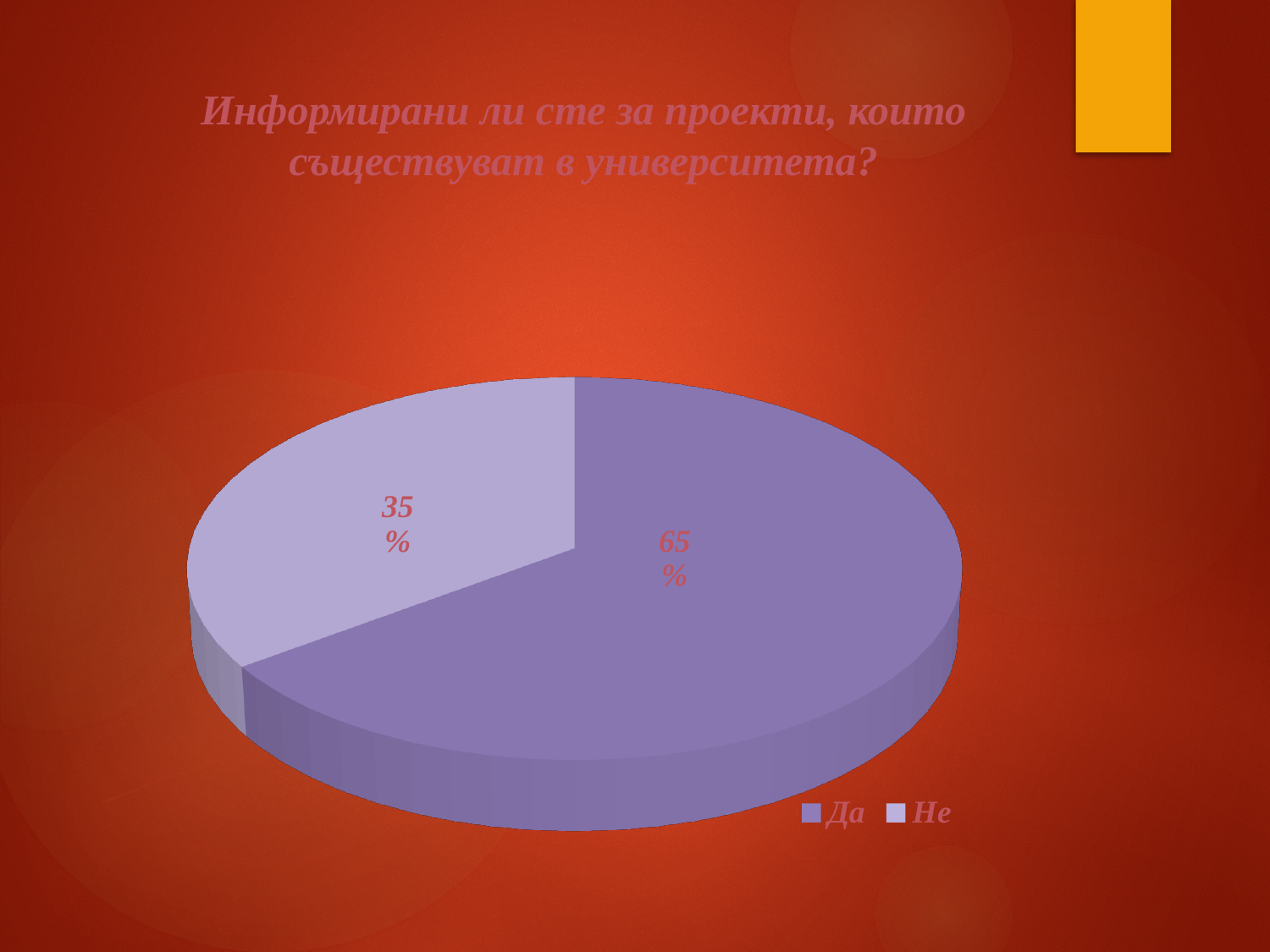
What percentage of the pie chart is labelled "Не"? 35% Which slice of the pie chart is the largest? Да What is the difference in percentage points between the "Да" and "Не" slices? 30 Which legend entry is shown in the lighter purple colour? Не What is the title of the chart on the slide? Информирани ли сте за проекти, които съществуват в университета? What share of the pie does the "Не" slice represent? 35% Which is larger, the "Да" slice or the "Не" slice? Да What kind of chart is shown on the slide? Pie chart How many entries does the legend list? 2 What percentage of the pie chart is labelled "Да"? 65% How many slices does the pie chart have? 2 Which slice of the pie chart is the smallest? Не